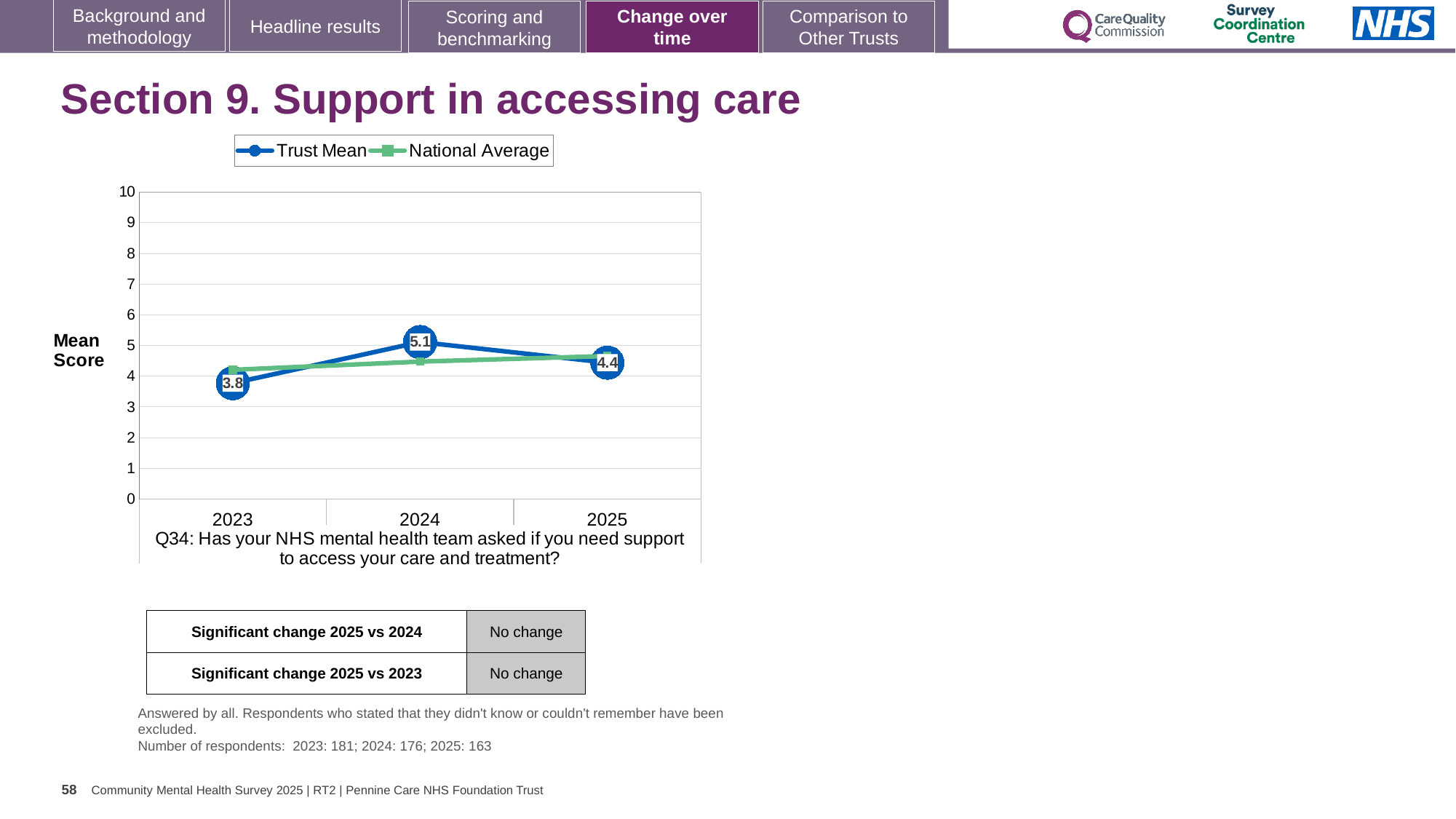
In which year is the Trust Mean score highest? 2024 How many series does the chart legend list? 2 What is the Trust Mean score for 2025? 4.4 Which year has the larger Trust Mean score, 2024 or 2025? 2024 How many years are shown on the x axis of the chart? 3 What is the Trust Mean score for 2024? 5.1 Is the National Average value for 2025 greater or less than 4? greater What kind of chart is shown on the slide? Line chart What is the difference between the Trust Mean scores for 2024 and 2023? 1.3 What is the Trust Mean score for 2023? 3.8 In which year is the Trust Mean score lowest? 2023 Does the Trust Mean score rise or fall from 2024 to 2025? Fall